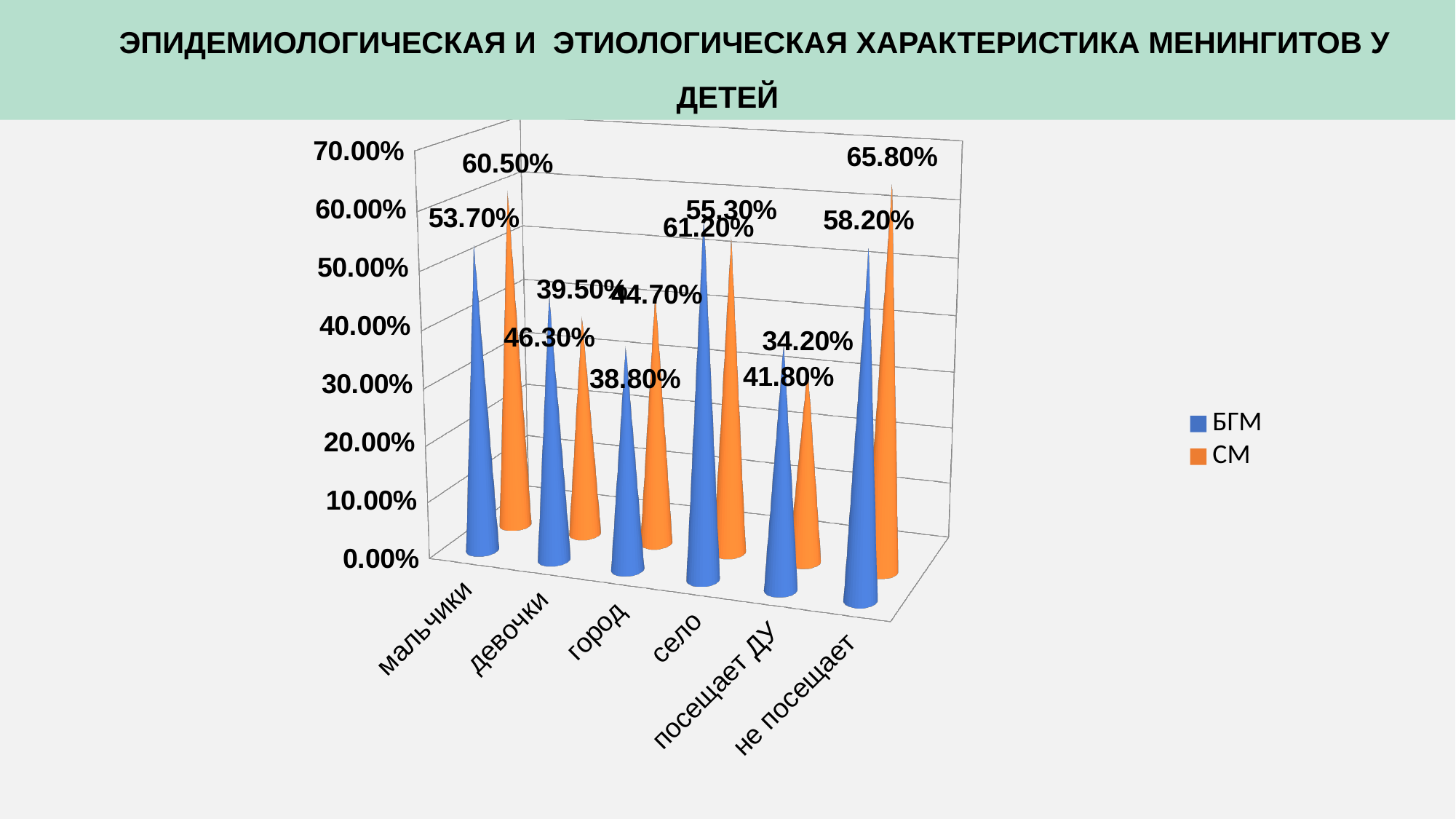
What is the difference between the СМ and БГМ values for мальчики? 6.80% What is the БГМ value for село? 61.20% How many series does the legend list? 2 What is the БГМ value for мальчики? 53.70% How many categories are shown on the x axis? 6 Which category has the lowest БГМ value? город What kind of chart is shown on the slide? bar chart Which colour represents the СМ series? orange For девочки, which series has the larger value, БГМ or СМ? БГМ What is the СМ value for посещает ДУ? 34.20% Which category has the highest СМ value? не посещает What is the СМ value for не посещает? 65.80%